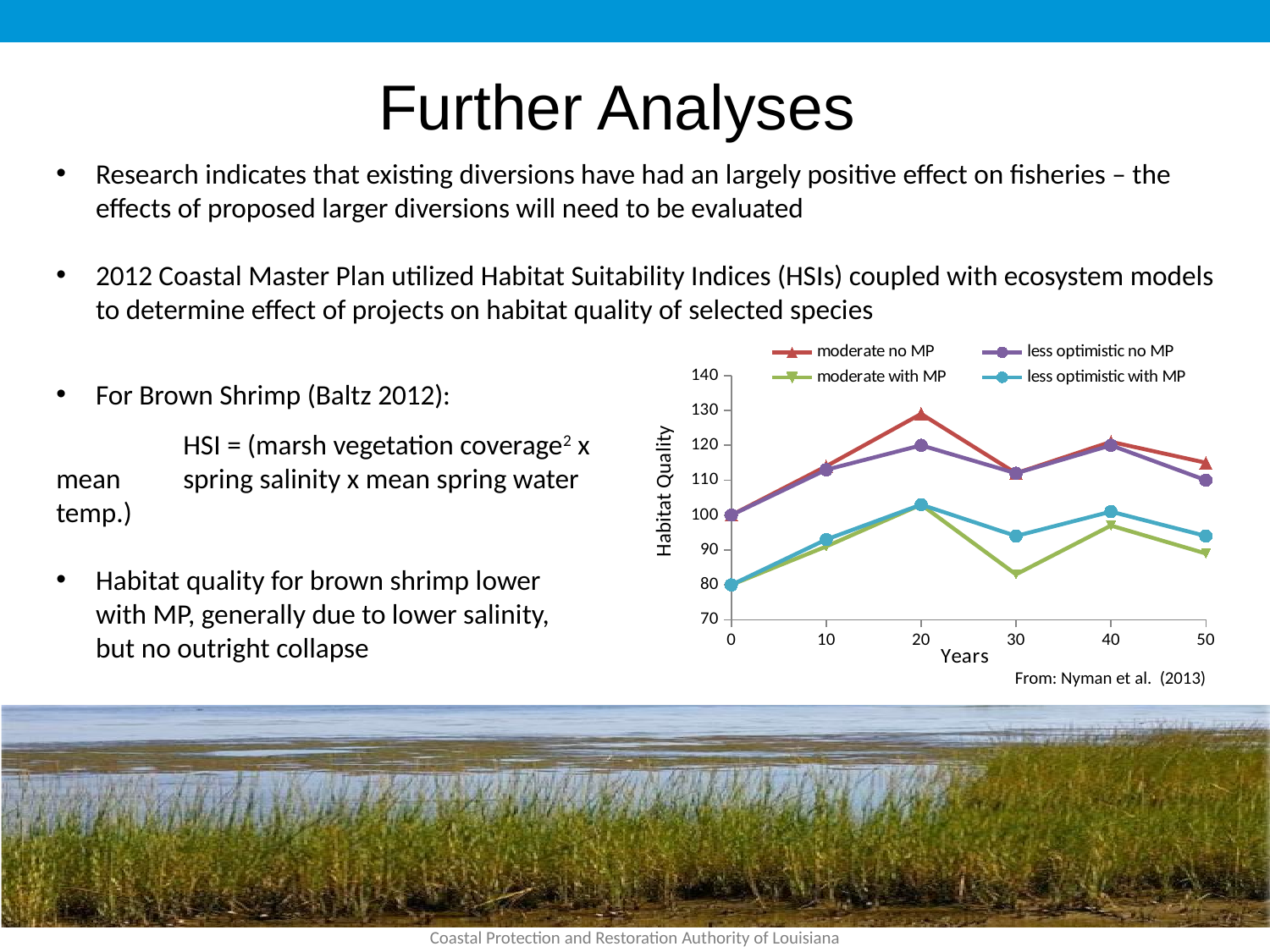
At year 30, which is larger: 'moderate with MP' or 'less optimistic with MP'? less optimistic with MP What kind of chart is shown on the slide? line chart Which series reaches the highest Habitat Quality value on the chart? moderate no MP Is the value for 'moderate with MP' at year 30 greater or less than 90? less What is the Habitat Quality value for 'less optimistic no MP' at year 20? 120 What is the Habitat Quality value for 'less optimistic no MP' at year 50? 110 How many data points are plotted for each series in the chart? 6 How many series does the chart legend list? 4 What is the Habitat Quality value for 'moderate with MP' at year 0? 80 What is the Habitat Quality value for 'moderate no MP' at year 0? 100 What is the label on the x axis of the chart? Years Is the value for 'moderate no MP' at year 20 greater or less than 120? greater